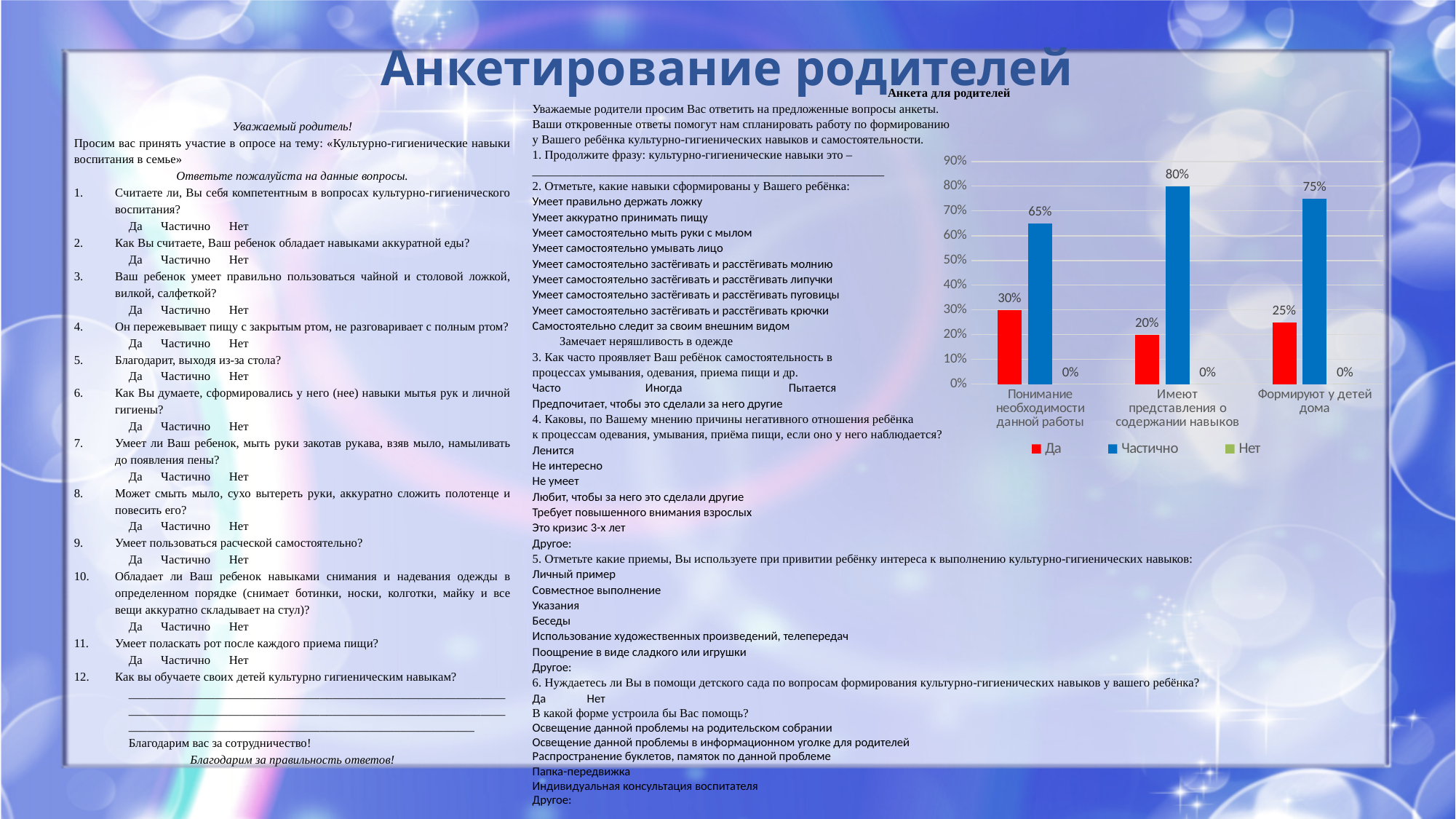
What kind of chart is shown on the slide? bar chart What is the difference between the "Частично" and "Да" values for "Формируют у детей дома"? 50% Which category has the lowest "Да" value? Имеют представления о содержании навыков How many categories are shown on the x axis of the chart? 3 Which category has the highest "Частично" value? Имеют представления о содержании навыков How many series does the chart legend list? 3 Which series in the legend is shown in red? Да What is the value of "Да" for "Имеют представления о содержании навыков"? 20% What is the value of "Частично" for "Формируют у детей дома"? 75% What is the value of "Частично" for "Понимание необходимости данной работы"? 65% What is the value of "Нет" for "Понимание необходимости данной работы"? 0% Which is larger: the "Да" value for "Понимание необходимости данной работы" or the "Да" value for "Формируют у детей дома"? Понимание необходимости данной работы